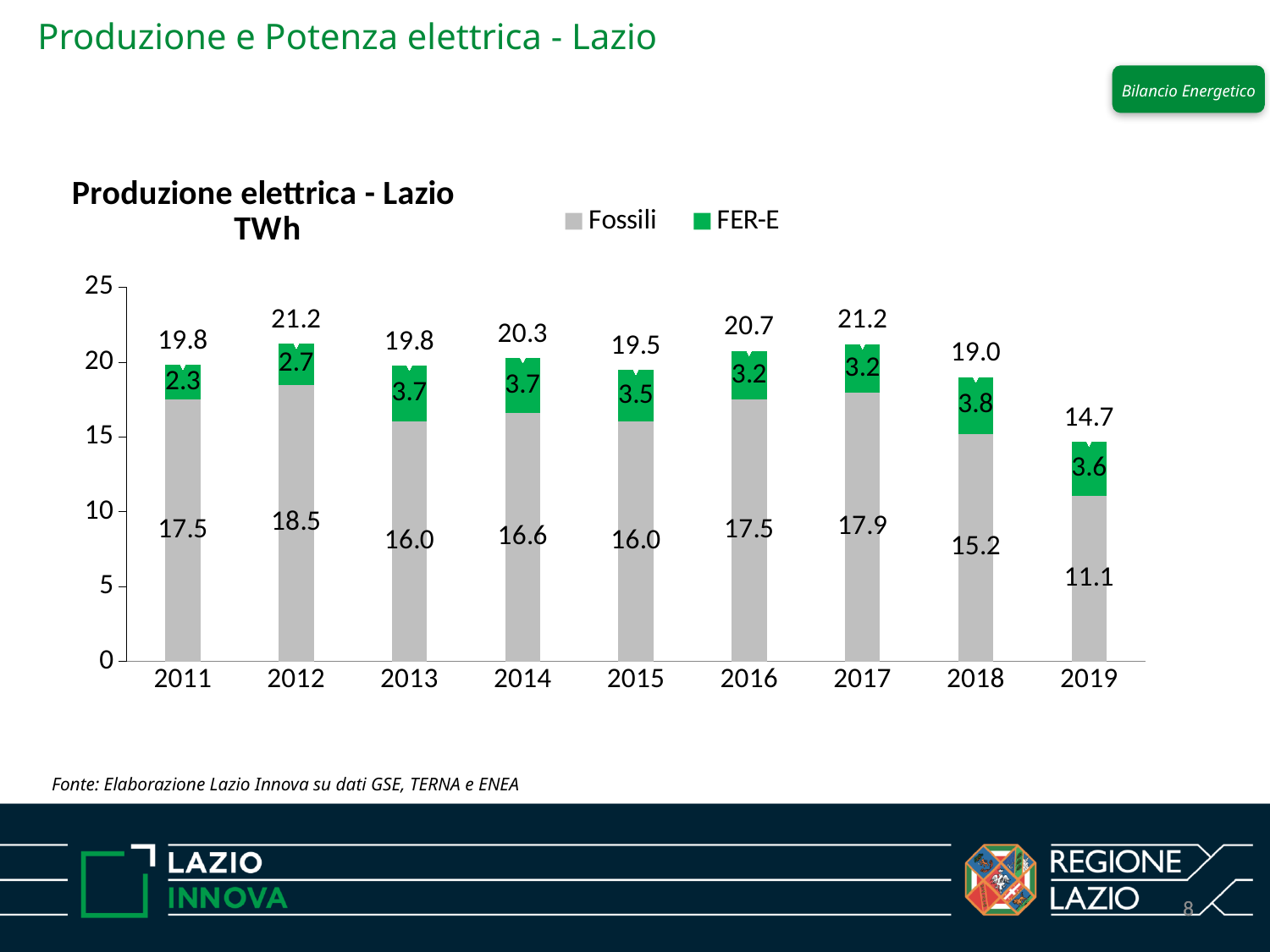
How many series does the legend list? 2 What is the Fossili value for 2012? 18.5 Is the FER-E value larger in 2011 or in 2013? 2013 Which year has the highest FER-E value? 2018 How many years are shown on the x axis? 9 Which series is shown in green in the legend? FER-E What is the total electricity production shown for 2019? 14.7 Which year has the lowest Fossili value? 2019 What is the difference between the Fossili values for 2017 and 2018? 2.7 What type of chart is shown on the slide? Stacked bar chart Which year has the lowest total electricity production? 2019 What is the FER-E value for 2018? 3.8